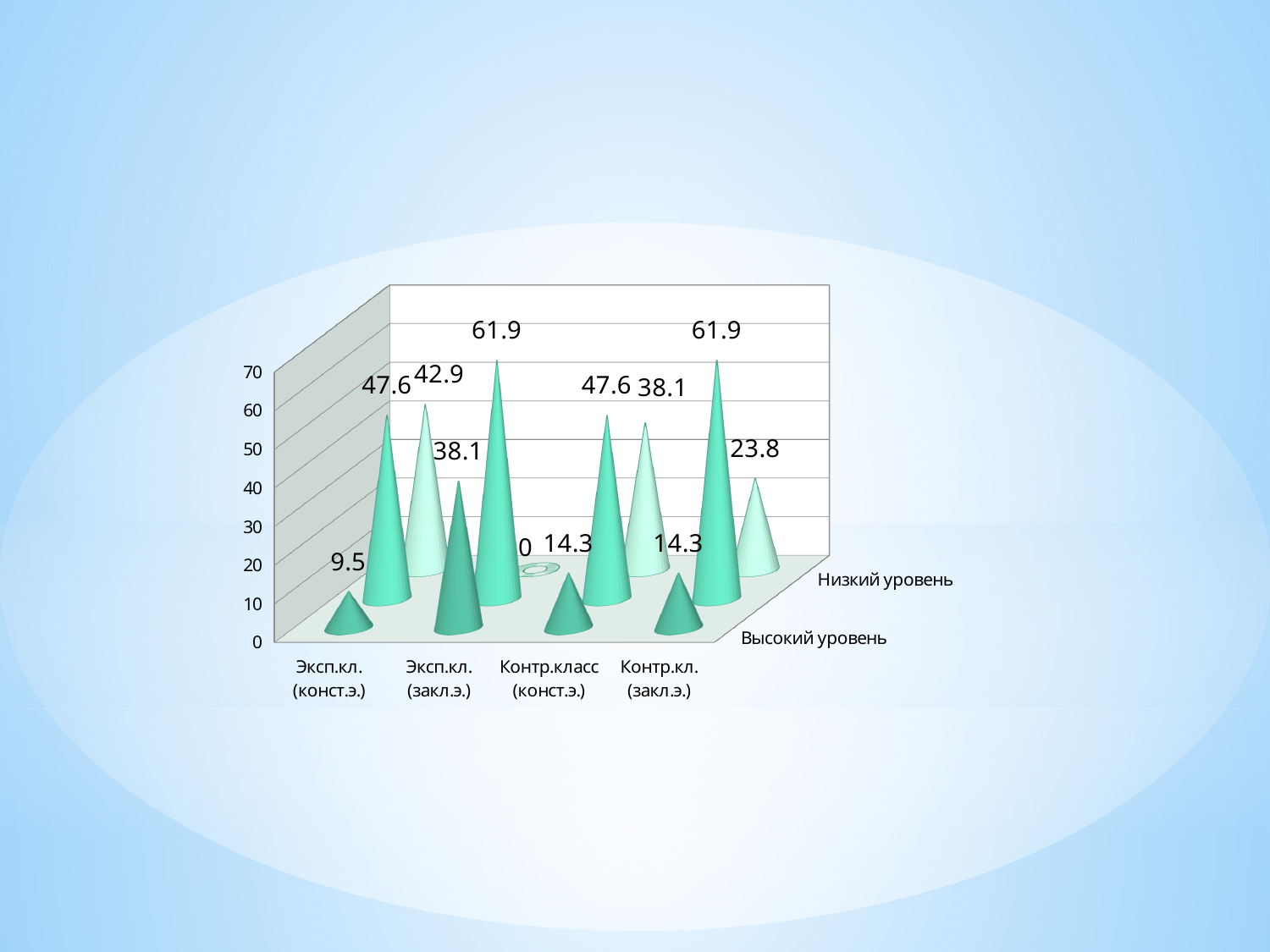
What is the value for Низкий уровень in the Контр.кл. (закл.э.) category? 23.8 What is the difference between the Высокий уровень values for Эксп.кл. (закл.э.) and Эксп.кл. (конст.э.)? 28.6 What is the value for Высокий уровень in the Эксп.кл. (конст.э.) category? 9.5 What is the value for Высокий уровень in the Контр.класс (конст.э.) category? 14.3 Which category has the lowest value for Низкий уровень? Эксп.кл. (закл.э.) What is the value for Высокий уровень in the Эксп.кл. (закл.э.) category? 38.1 Which is larger: the Низкий уровень value for Контр.класс (конст.э.) or for Контр.кл. (закл.э.)? Контр.класс (конст.э.) Which category has the highest value for Высокий уровень? Эксп.кл. (закл.э.) What is the value for Низкий уровень in the Эксп.кл. (закл.э.) category? 0 How many categories are shown on the x axis? 4 What is the maximum value shown on the vertical axis? 70 What type of chart is shown on the slide? 3D cone bar chart